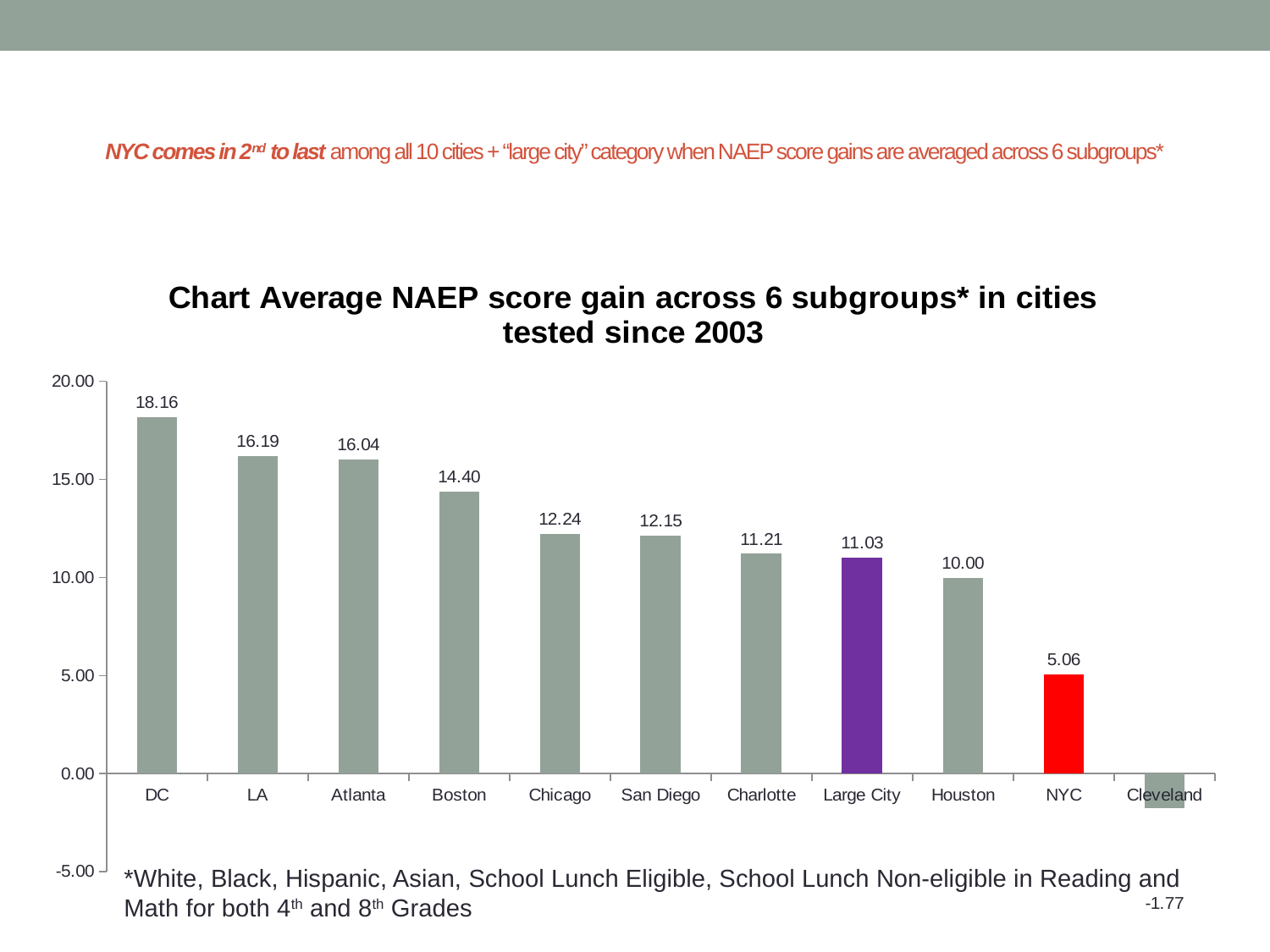
Is the value for Chicago greater or less than 10.00? greater What is the average NAEP score gain for NYC? 5.06 Which has a larger average NAEP score gain, Boston or Houston? Boston What is the average NAEP score gain for DC? 18.16 Which bar is coloured red? NYC Which city has the lowest average NAEP score gain? Cleveland What kind of chart is shown on the slide? Bar chart How many categories are shown on the x axis? 11 Which city has the highest average NAEP score gain? DC What is the value shown for Large City? 11.03 Do the values generally rise or fall from left to right along the x axis? Fall What is the difference between the values for DC and NYC? 13.10